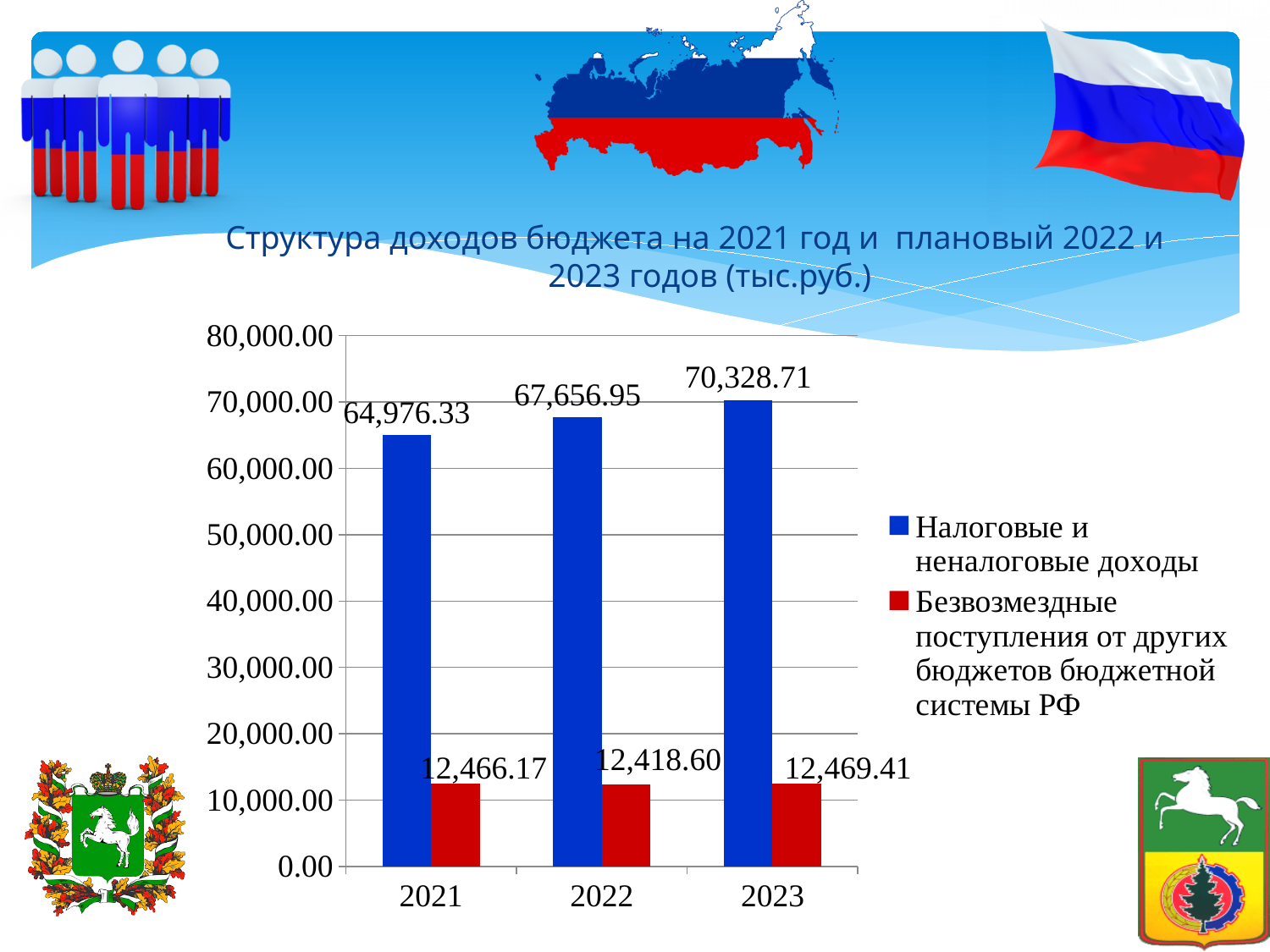
What is the value of Налоговые и неналоговые доходы for 2021? 64,976.33 Which is larger in 2022: Налоговые и неналоговые доходы or Безвозмездные поступления от других бюджетов? Налоговые и неналоговые доходы What is the value of Налоговые и неналоговые доходы for 2023? 70,328.71 What is the difference between Налоговые и неналоговые доходы and Безвозмездные поступления in 2021? 52,510.16 How many series does the legend list? 2 In which year is Налоговые и неналоговые доходы the lowest? 2021 What is the difference between Налоговые и неналоговые доходы in 2023 and in 2021? 5,352.38 In which year is Налоговые и неналоговые доходы the highest? 2023 What is the value of Безвозмездные поступления от других бюджетов бюджетной системы РФ for 2023? 12,469.41 Do the values of Налоговые и неналоговые доходы rise or fall from 2021 to 2023? rise What type of chart is shown on the slide? bar chart What is the value of Безвозмездные поступления от других бюджетов бюджетной системы РФ for 2022? 12,418.60